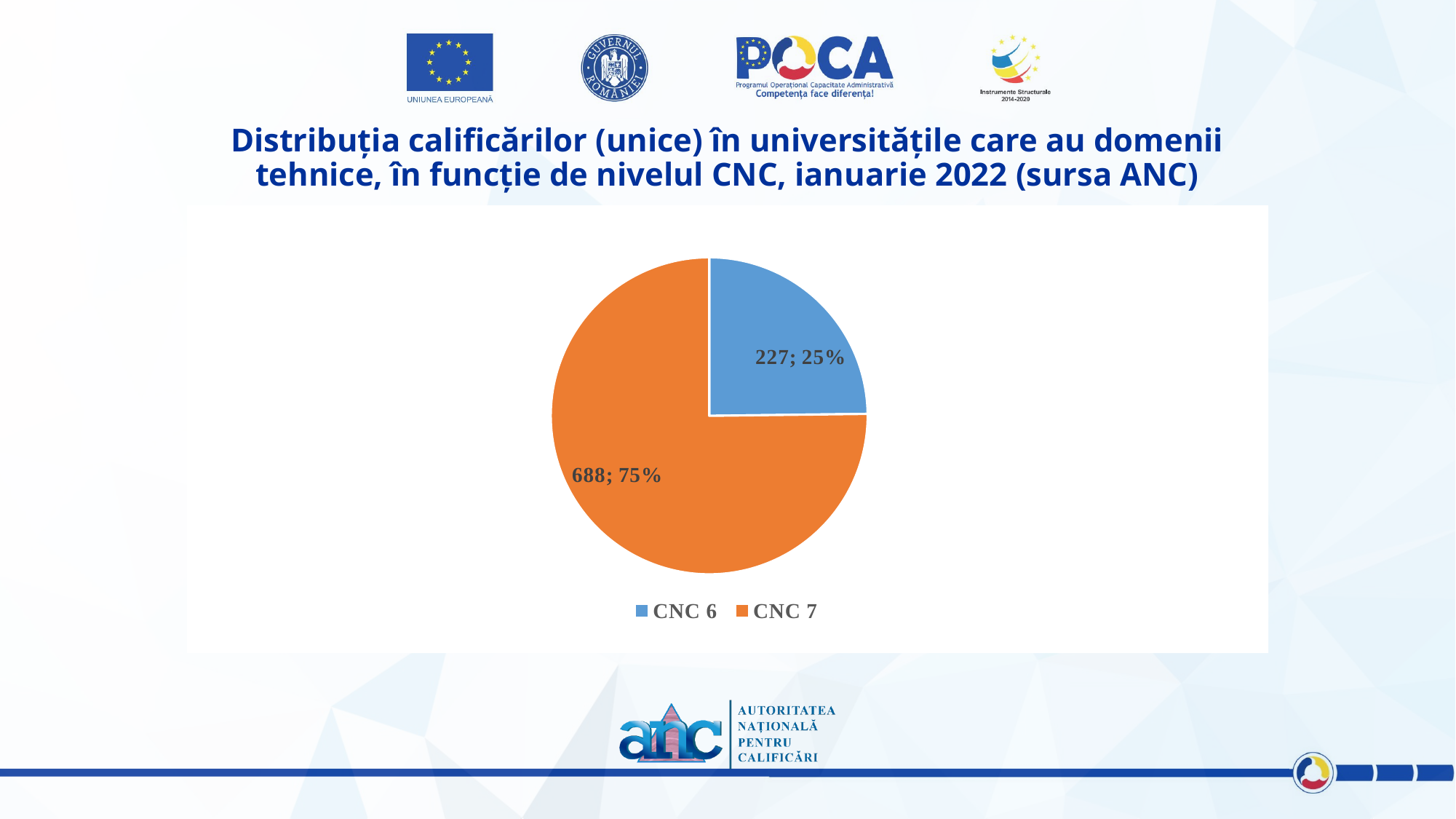
What is the difference between the number of qualifications for CNC 7 and CNC 6? 461 What colour is the CNC 7 slice? orange What is the total number of qualifications shown across both slices? 915 Which CNC level has the largest slice of the pie? CNC 7 What percentage share of the pie does CNC 7 have? 75% What percentage share of the pie does CNC 6 have? 25% How many qualifications are shown for CNC 6? 227 What type of chart is shown on the slide? pie chart Which is larger, the value for CNC 6 or the value for CNC 7? CNC 7 Which CNC level has the smallest slice of the pie? CNC 6 How many qualifications are shown for CNC 7? 688 How many slices does the pie chart have? 2